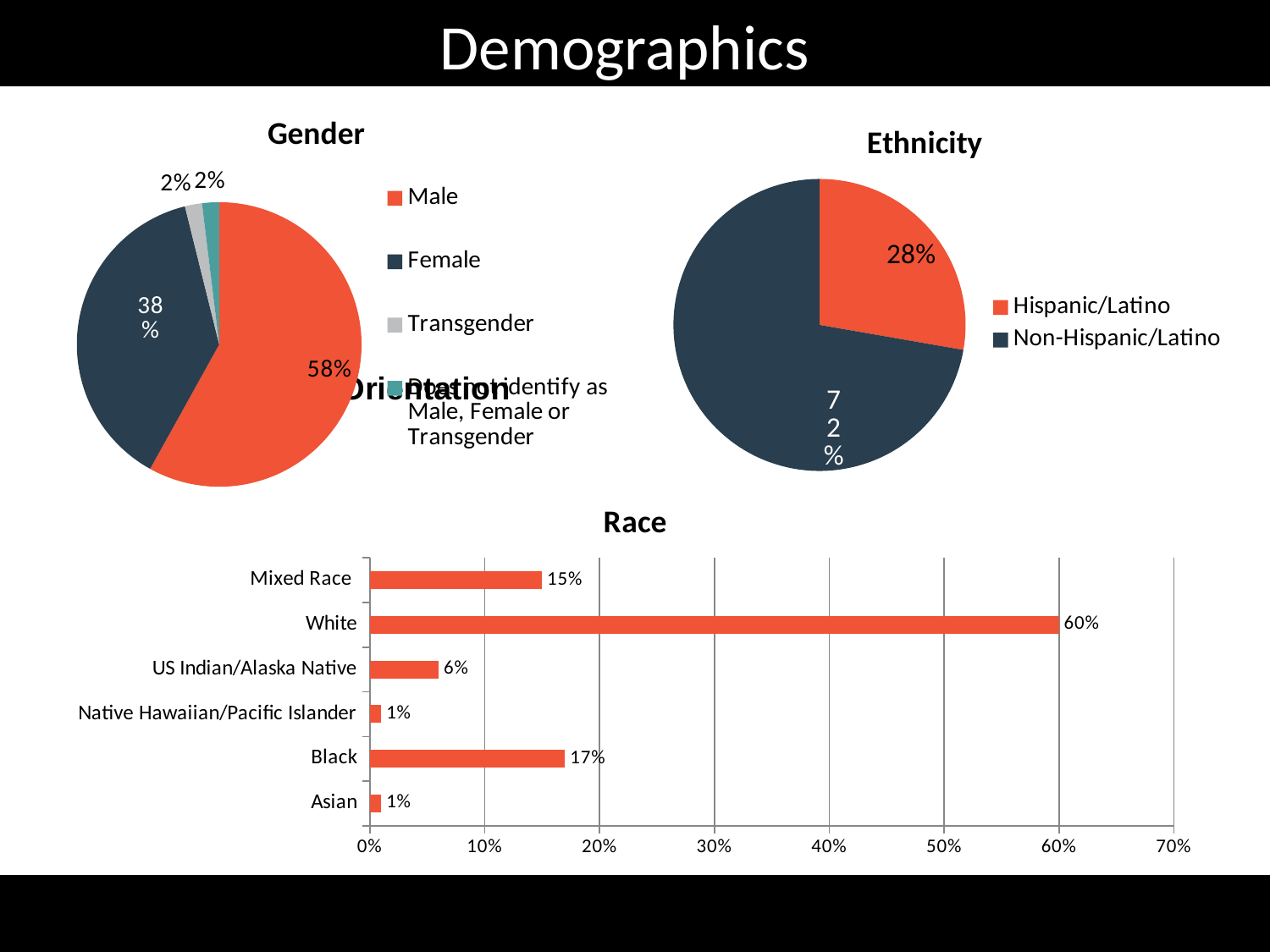
In the Race chart, what is the value for US Indian/Alaska Native? 6% In the Race chart, what is the value for Black? 17% In the Gender pie chart, what share is Female? 38% In the Gender pie chart, what share is Male? 58% In the Race chart, how many race categories are shown? 6 In the Ethnicity pie chart, what share is Hispanic/Latino? 28% In the Race chart, which category has the highest value? White In the Gender pie chart, which category has the largest share? Male In the Ethnicity pie chart, what is the difference between the Non-Hispanic/Latino and Hispanic/Latino shares? 44% What kind of chart is the Race chart? Bar chart